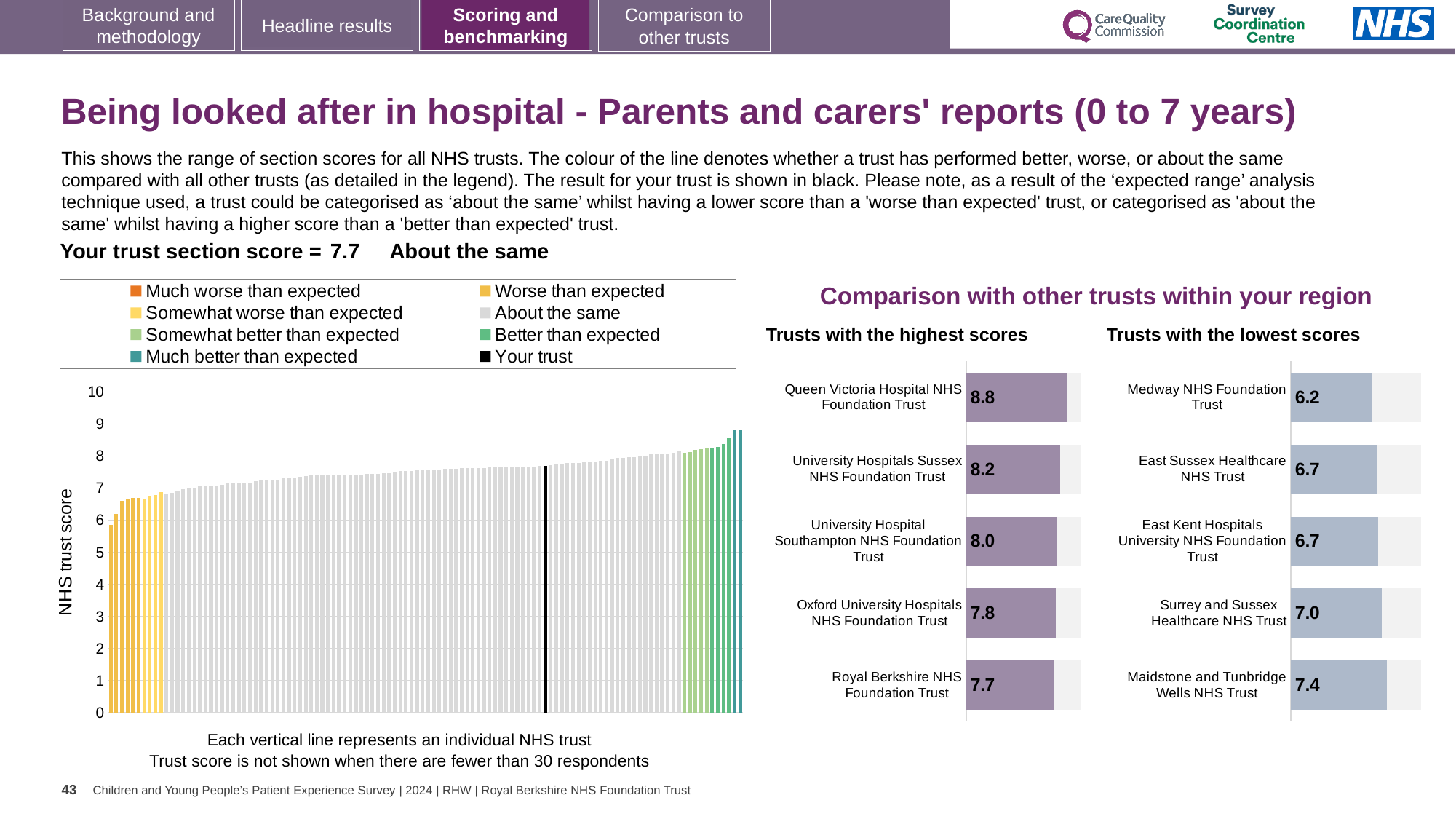
In the 'Trusts with the highest scores' chart, what is the score for Queen Victoria Hospital NHS Foundation Trust? 8.8 In the 'Trusts with the highest scores' chart, which trust has the lowest score? Royal Berkshire NHS Foundation Trust How many trusts are shown in the 'Trusts with the lowest scores' chart? 5 Which has a higher score: Oxford University Hospitals NHS Foundation Trust in the highest-scores chart or Surrey and Sussex Healthcare NHS Trust in the lowest-scores chart? Oxford University Hospitals NHS Foundation Trust What kind of chart is the large 'NHS trust score' chart on the left? Bar chart In the 'Trusts with the lowest scores' chart, what is the score for Medway NHS Foundation Trust? 6.2 In the 'Trusts with the lowest scores' chart, which trust has the highest score? Maidstone and Tunbridge Wells NHS Trust In the 'Trusts with the lowest scores' chart, what is the difference between the scores of Maidstone and Tunbridge Wells NHS Trust and Medway NHS Foundation Trust? 1.2 How many entries does the legend of the 'NHS trust score' chart list? 8 In the 'Trusts with the highest scores' chart, what is the difference between the scores of Queen Victoria Hospital NHS Foundation Trust and Royal Berkshire NHS Foundation Trust? 1.1 In the 'NHS trust score' chart, is the value of the tallest bar greater or less than 8? greater In the 'Trusts with the highest scores' chart, what is the score for Royal Berkshire NHS Foundation Trust? 7.7